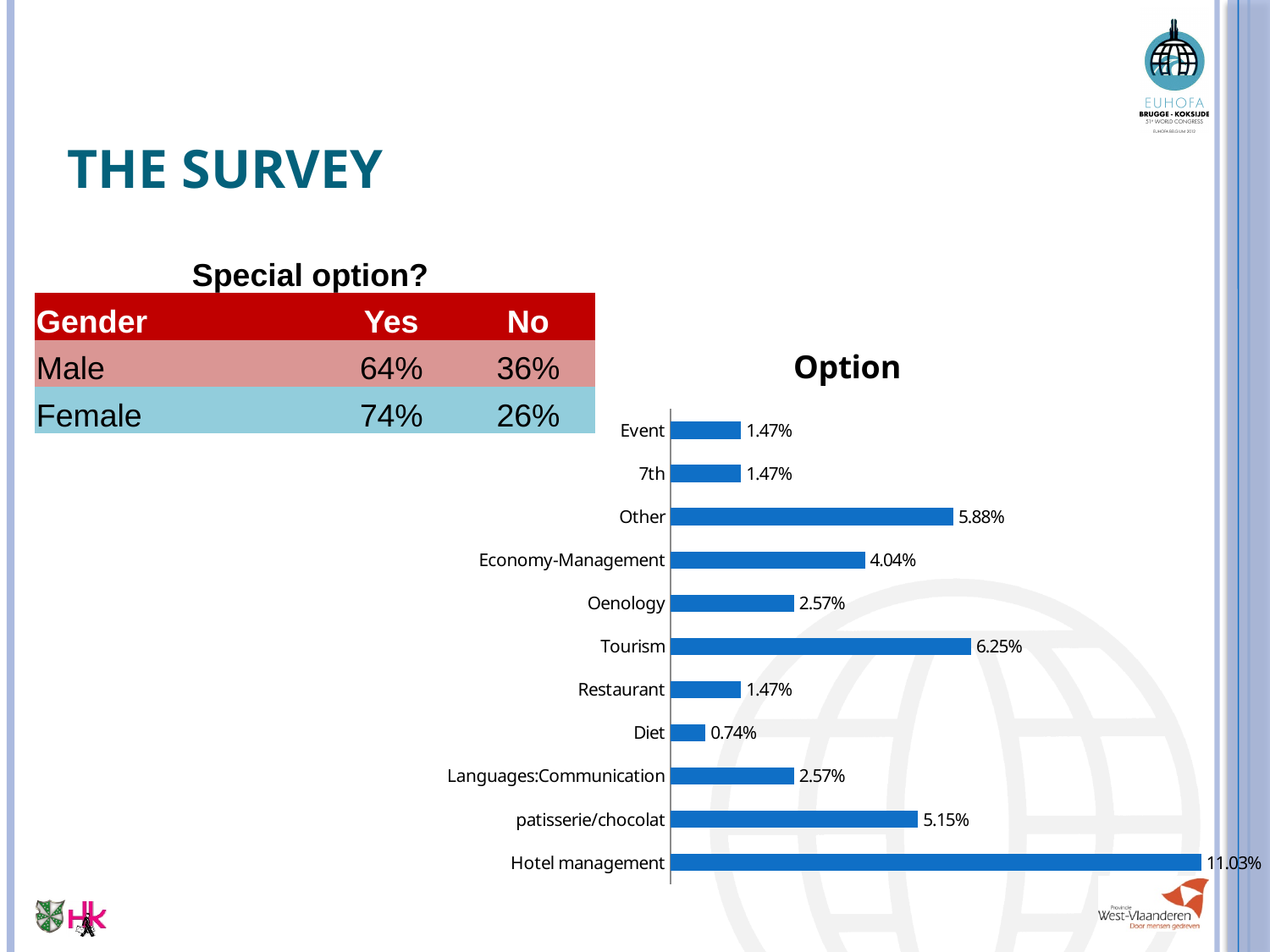
What kind of chart is shown under the title "Option"? Bar chart What is the title of the bar chart on the slide? Option What is the value for Economy-Management in the Option chart? 4.04% What is the difference between the values for Other and patisserie/chocolat in the Option chart? 0.73% What is the difference between the values for Hotel management and Tourism in the Option chart? 4.78% How many categories are shown in the Option chart? 11 Which category has the lowest value in the Option chart? Diet What is the value for Hotel management in the Option chart? 11.03% Which category has the highest value in the Option chart? Hotel management What is the value for patisserie/chocolat in the Option chart? 5.15% In the Option chart, which is larger: Oenology or Economy-Management? Economy-Management What is the value for Tourism in the Option chart? 6.25%